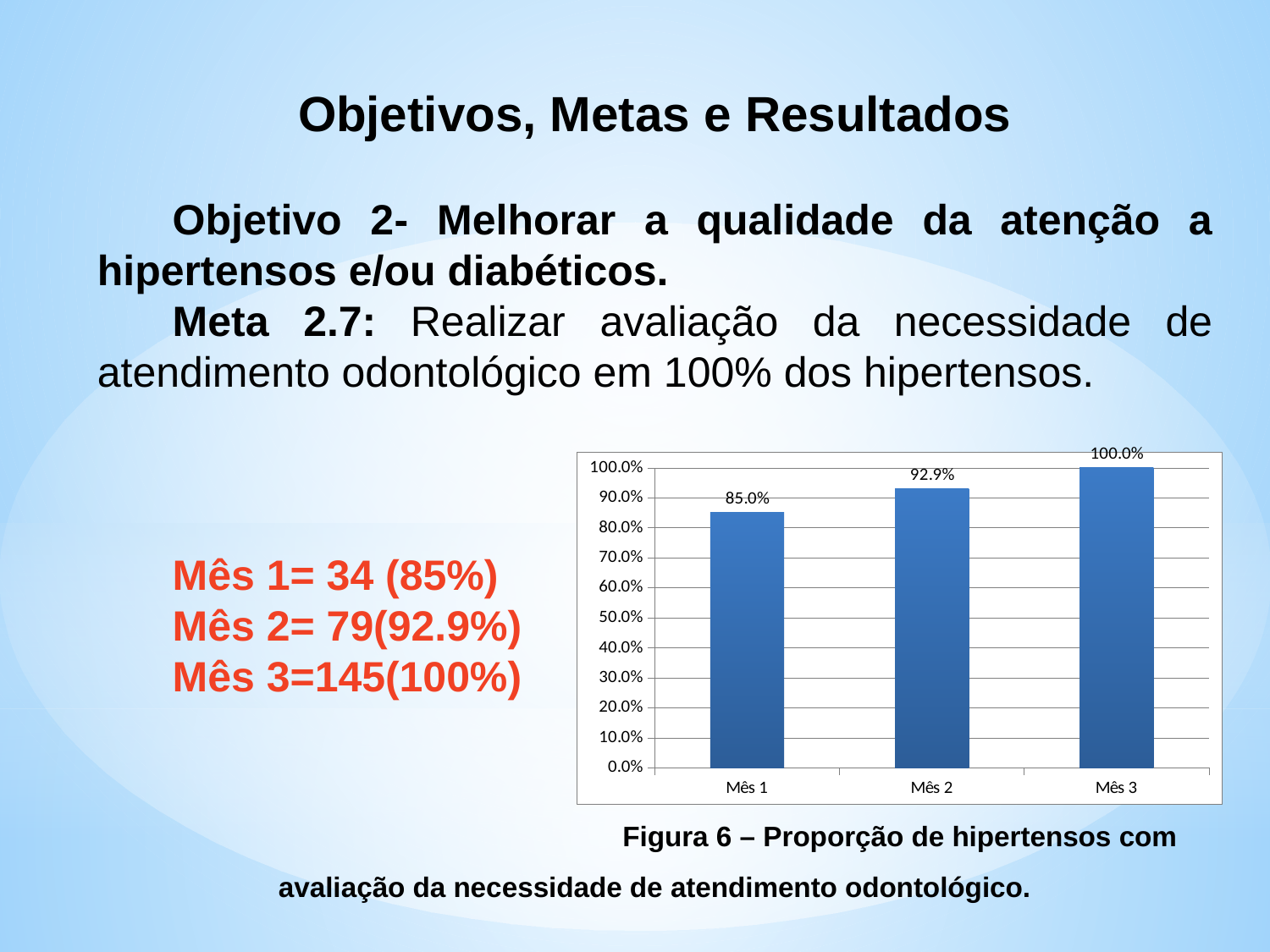
Which month has the lowest value? Mês 1 Which month has the highest value? Mês 3 What is the value for Mês 3? 100.0% Which is larger, the value for Mês 1 or the value for Mês 2? Mês 2 What is the value for Mês 1? 85.0% What is the difference between the values for Mês 2 and Mês 1? 7.9% How many categories are shown on the x axis? 3 What is the value for Mês 2? 92.9% What kind of chart is shown? bar chart What is the difference between the values for Mês 3 and Mês 1? 15.0% Is the value for Mês 1 greater or less than 90.0%? less Do the values rise or fall from Mês 1 to Mês 3? rise